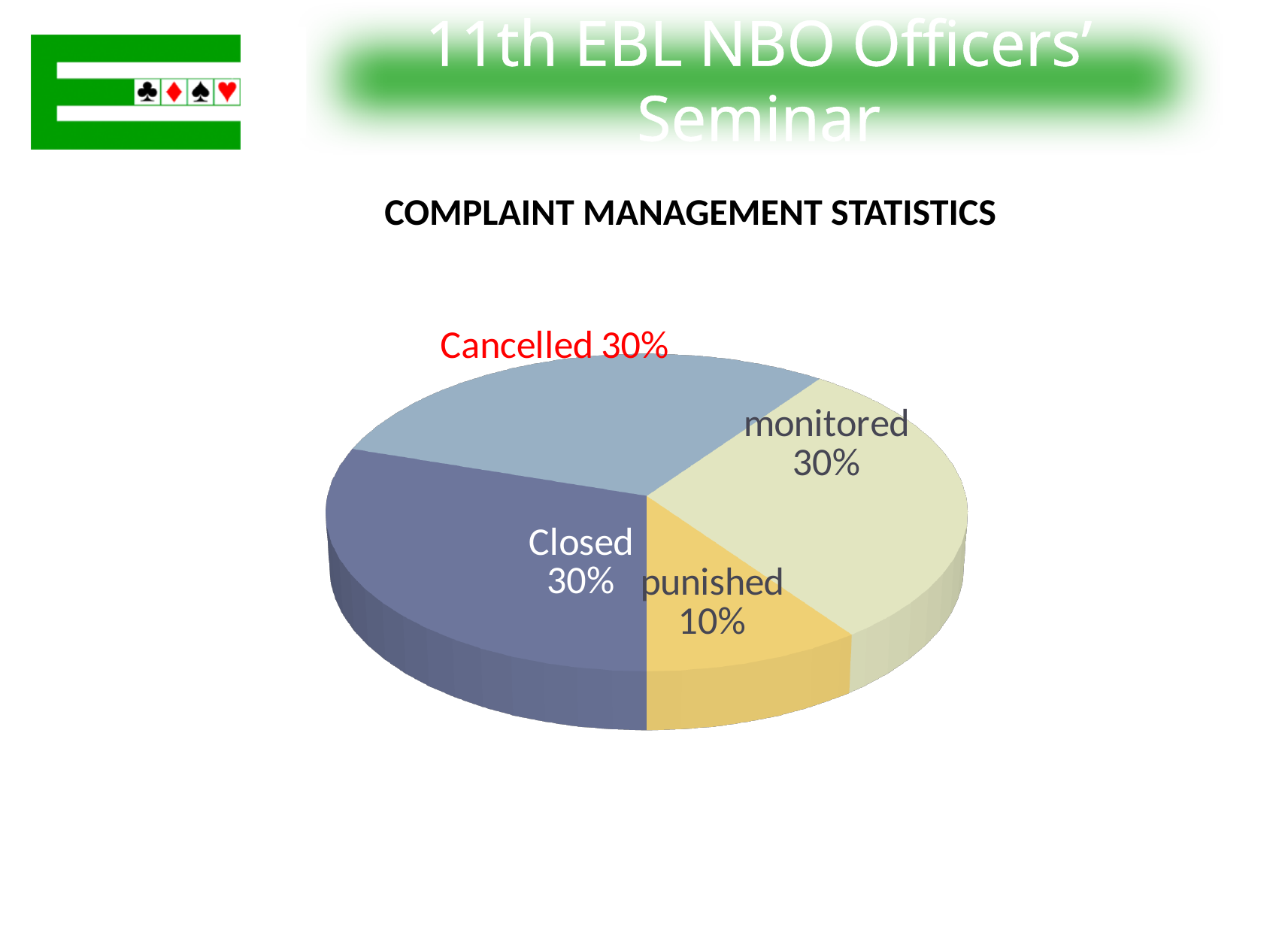
What kind of chart is shown on the slide? pie chart What is the difference between the Closed share and the punished share? 20% Which is larger, the monitored slice or the punished slice? monitored What is the combined share of the Cancelled and Closed slices? 60% Which slice of the pie is the smallest? punished What share of the pie is labelled Cancelled? 30% What share of the pie is labelled punished? 10% What is the title shown above the pie chart? COMPLAINT MANAGEMENT STATISTICS What share of the pie is labelled Closed? 30% How many slices does the pie chart have? 4 Which slice label is written in red text? Cancelled 30%